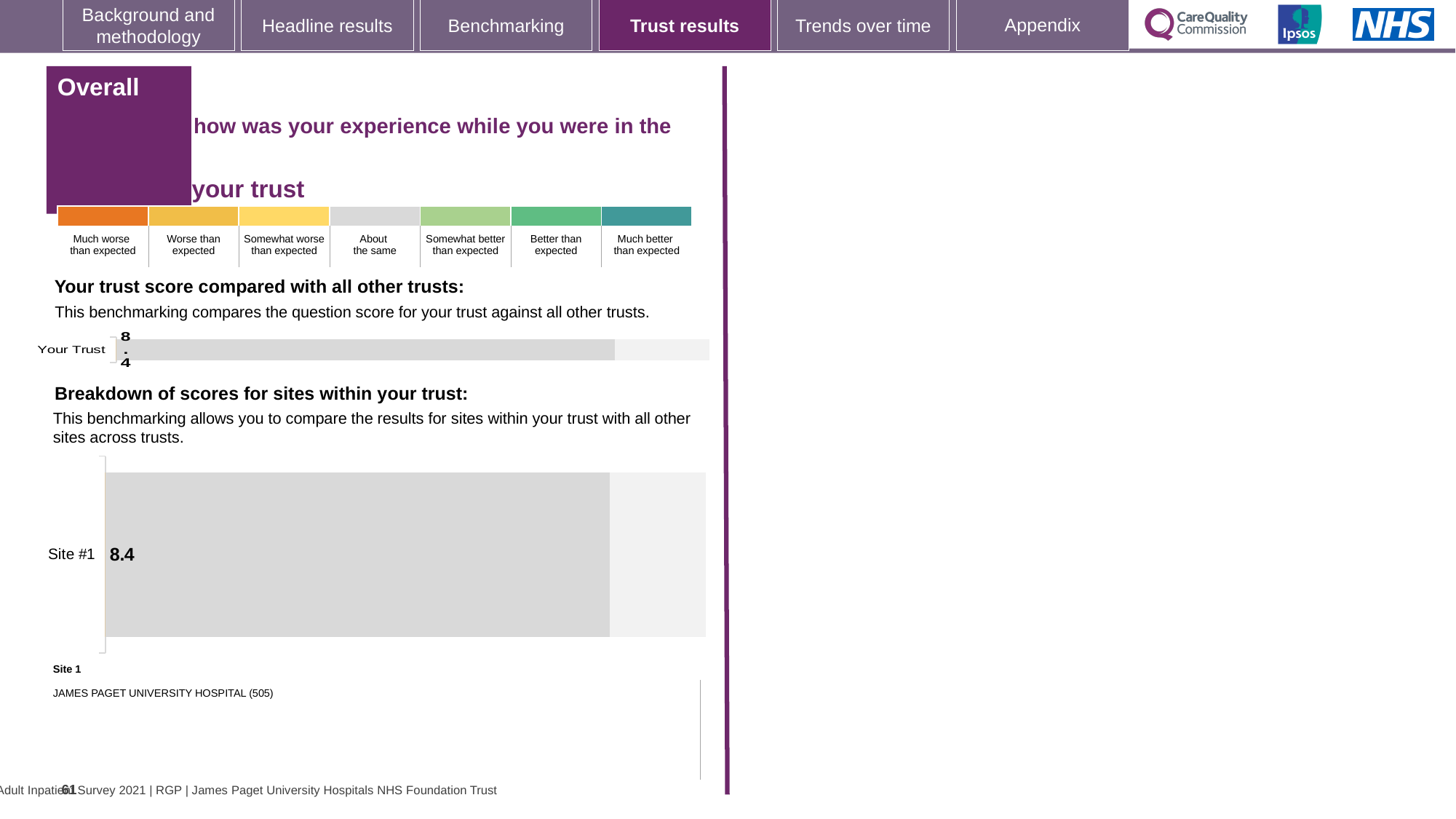
Is the value for Site #1 in the 'Breakdown of scores for sites within your trust' chart greater or less than 9? less How many bars are plotted in the 'Your trust score compared with all other trusts' chart? 1 Which hospital is listed as Site 1 below the 'Breakdown of scores for sites within your trust' chart? JAMES PAGET UNIVERSITY HOSPITAL (505) What is the difference between the Site #1 score in the breakdown chart and the Your Trust score in the trust comparison chart? 0 What kind of chart is the 'Breakdown of scores for sites within your trust' chart? bar chart What kind of chart is the 'Your trust score compared with all other trusts' chart? bar chart How many sites are plotted in the 'Breakdown of scores for sites within your trust' chart? 1 In the 'Your trust score compared with all other trusts' chart, what is the value for Your Trust? 8.4 In the 'Breakdown of scores for sites within your trust' chart, what is the value for Site #1? 8.4 Is the value for Your Trust in the 'Your trust score compared with all other trusts' chart greater or less than 8? greater How many rating categories does the colour key above the charts list, from 'Much worse than expected' to 'Much better than expected'? 7